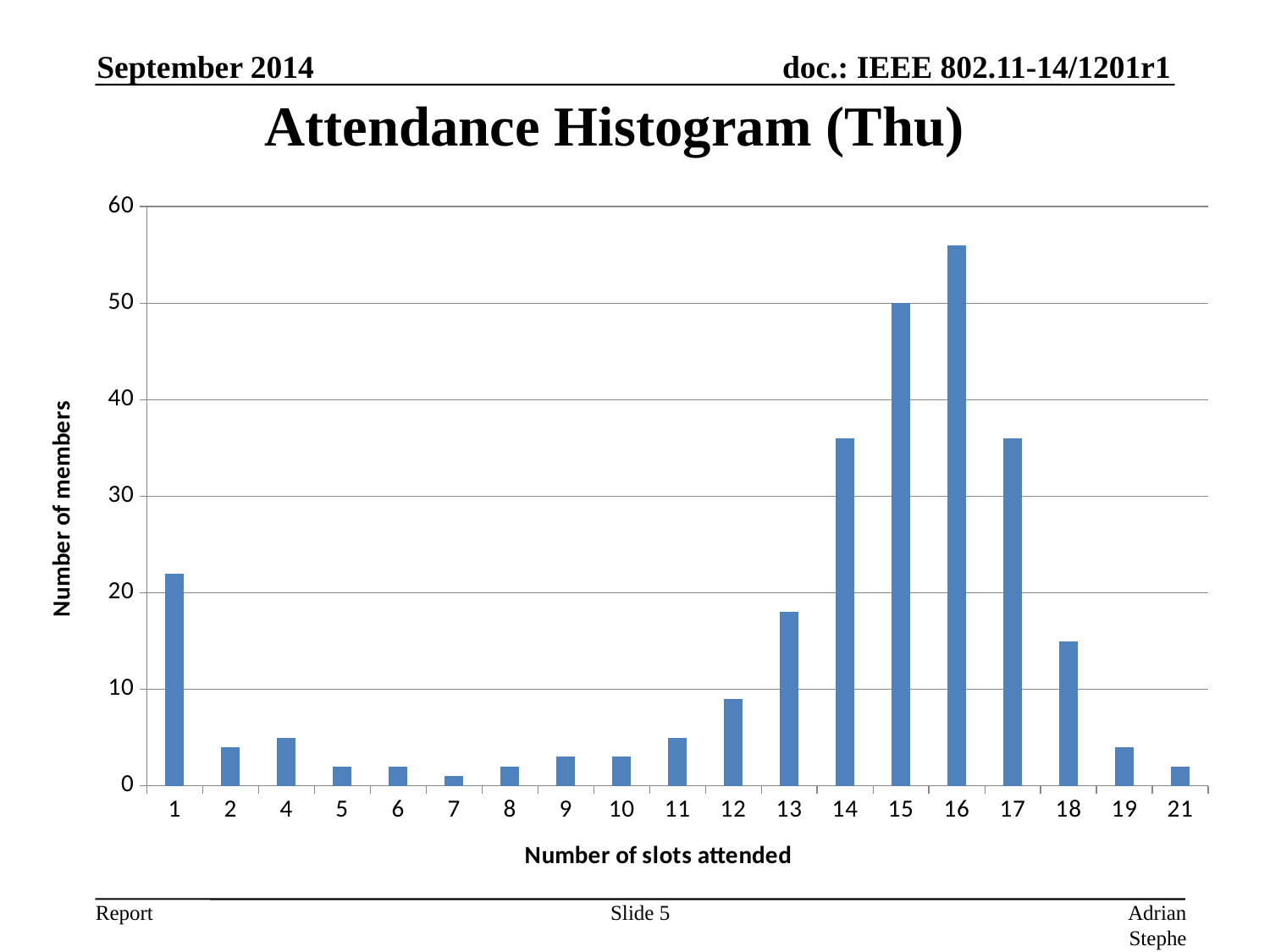
What is the number of members for 15 slots attended? 50 Which has more members: 1 slot attended or 18 slots attended? 1 How many categories (numbers of slots attended) are shown on the x axis? 19 What is the label of the vertical axis? Number of members Is the number of members for 13 slots attended greater or less than 20? less Is the number of members for 1 slot attended greater or less than 10? greater Which number of slots attended has the highest number of members? 16 What is the title of the chart? Attendance Histogram (Thu) Which has more members: 13 slots attended or 14 slots attended? 14 Is the number of members for 14 slots attended greater or less than 30? greater What kind of chart is shown on the slide? bar chart